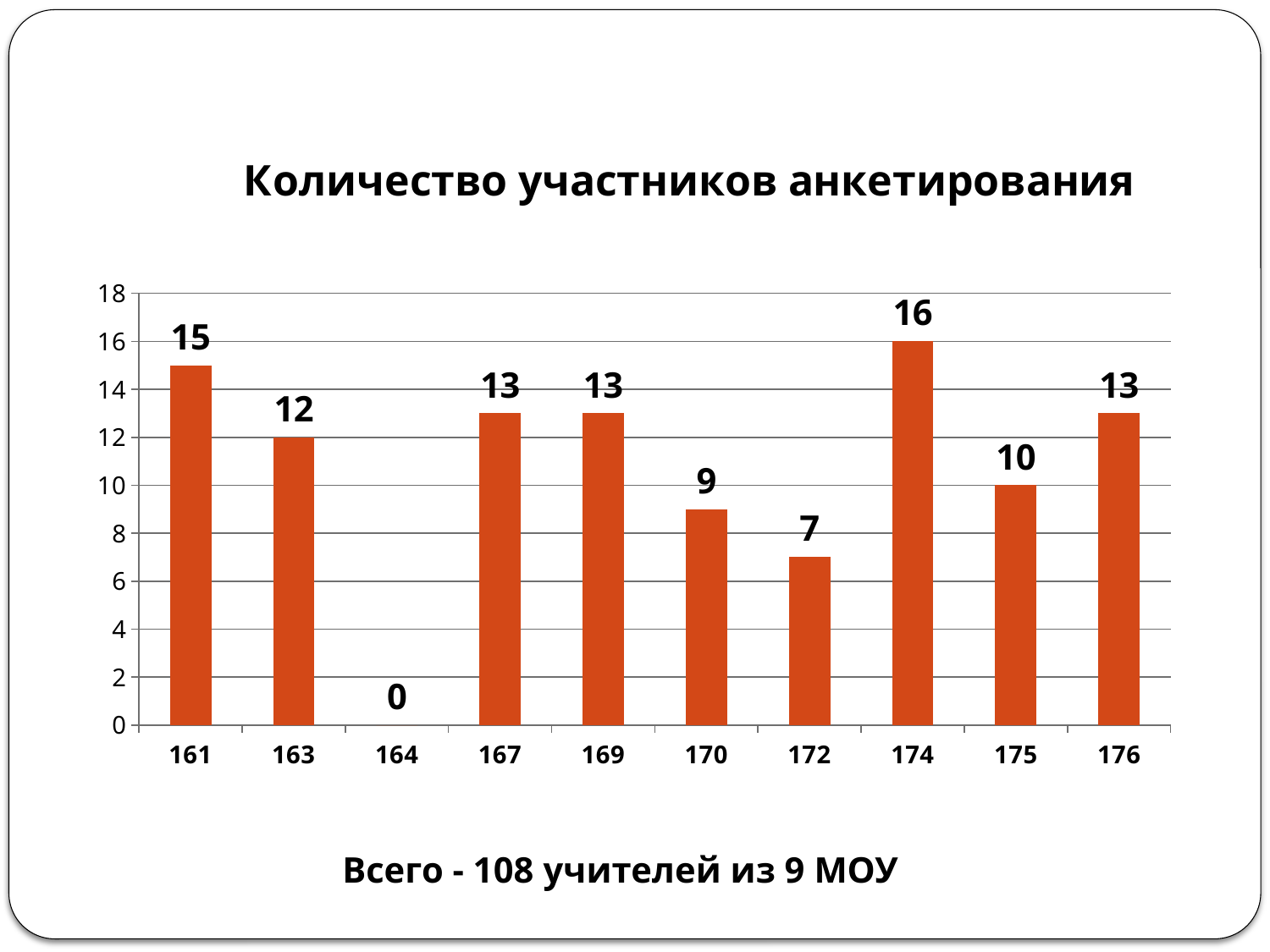
What is the difference between the values for 174 and 175? 6 Which category has the lowest value? 164 Which is larger, the value for 163 or the value for 170? 163 How many categories are shown on the x axis? 10 What is the value for category 161? 15 Is the value for 176 greater or less than 10? greater What is the difference between the values for 161 and 163? 3 Which category has the highest value? 174 What kind of chart is this? bar chart What is the title of the chart? Количество участников анкетирования What is the value for category 172? 7 What is the value for category 164? 0